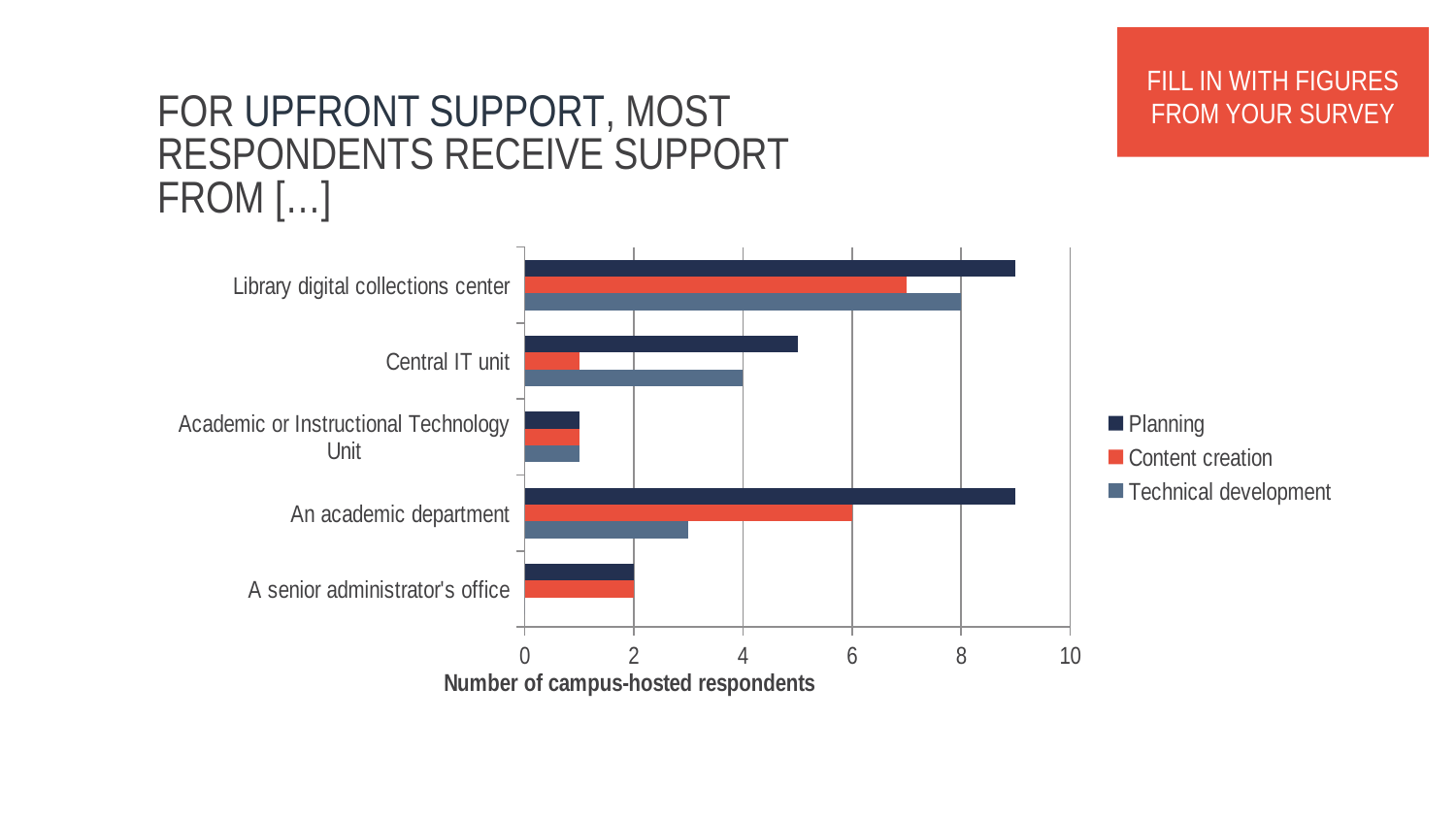
What is the Technical development value for Library digital collections center? 8 Is the Planning value for Central IT unit greater or less than 4? greater Which category has the lowest Planning value? Academic or Instructional Technology Unit How many categories are shown on the vertical axis of the chart? 5 Which is larger, the Content creation value for Library digital collections center or for Central IT unit? Library digital collections center How many series does the legend list? 3 What is the Content creation value for An academic department? 6 What is the Technical development value for Central IT unit? 4 Is the Technical development value for An academic department greater or less than 4? less What kind of chart is shown on the slide? bar chart Is the Planning value for Library digital collections center greater or less than 8? greater What is the Planning value for A senior administrator's office? 2